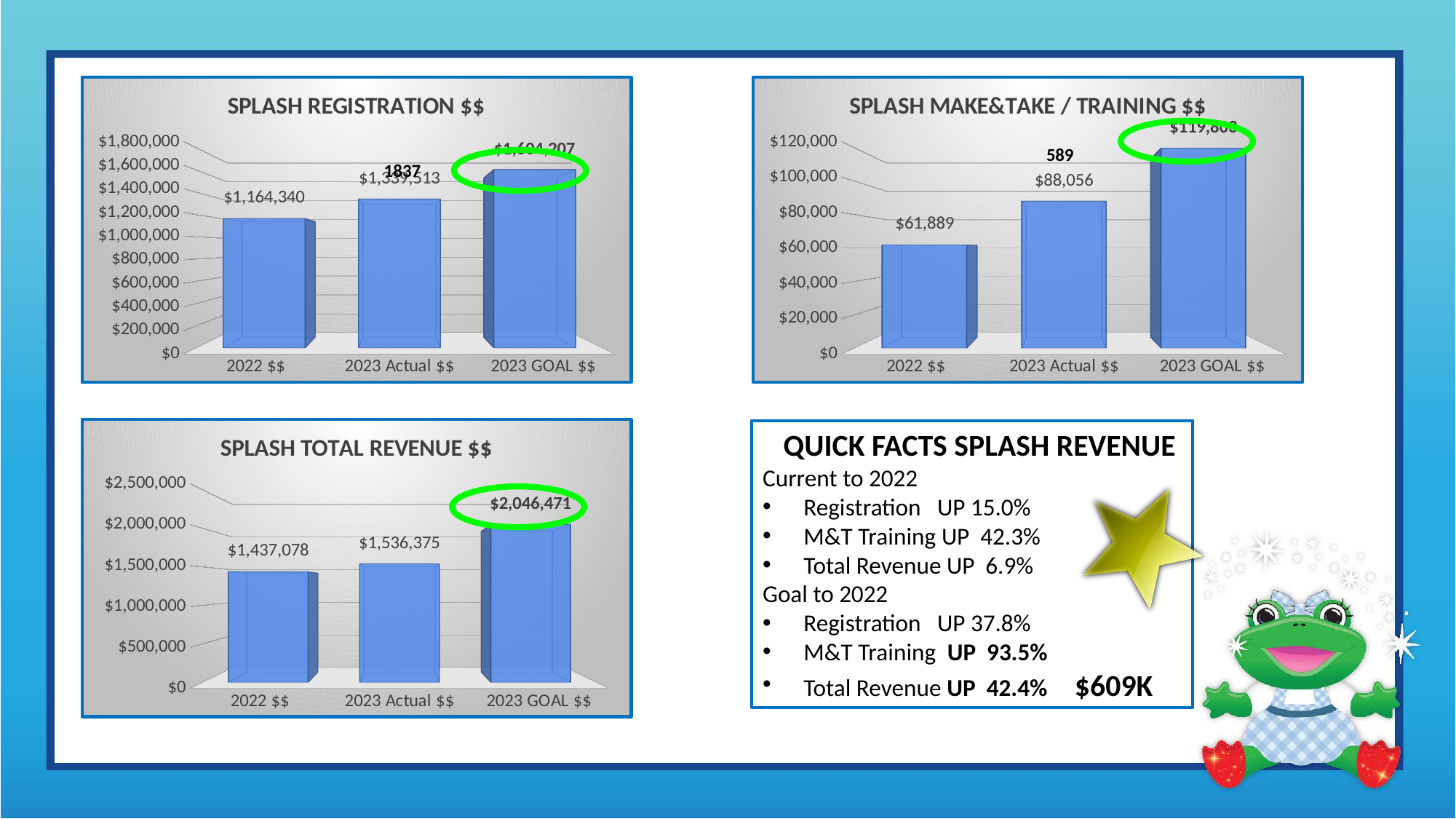
What kind of chart is the SPLASH REGISTRATION $$ chart? bar chart In the SPLASH MAKE&TAKE / TRAINING $$ chart, what is the value for 2022 $$? $61,889 In the SPLASH MAKE&TAKE / TRAINING $$ chart, which category has the lowest value? 2022 $$ In the SPLASH MAKE&TAKE / TRAINING $$ chart, is the value for 2023 GOAL $$ greater or less than $100,000? greater In the SPLASH MAKE&TAKE / TRAINING $$ chart, what is the value for 2023 Actual $$? $88,056 In the SPLASH TOTAL REVENUE $$ chart, do the values rise or fall from 2022 $$ to 2023 GOAL $$? rise In the SPLASH MAKE&TAKE / TRAINING $$ chart, what is the difference between 2023 Actual $$ and 2022 $$? $26,167 In the SPLASH REGISTRATION $$ chart, which category has the highest value? 2023 GOAL $$ In the SPLASH TOTAL REVENUE $$ chart, what is the value for 2022 $$? $1,437,078 In the SPLASH REGISTRATION $$ chart, what is the value for 2022 $$? $1,164,340 In the SPLASH TOTAL REVENUE $$ chart, what is the difference between 2023 Actual $$ and 2022 $$? $99,297 In the SPLASH TOTAL REVENUE $$ chart, what is the value for 2023 GOAL $$? $2,046,471